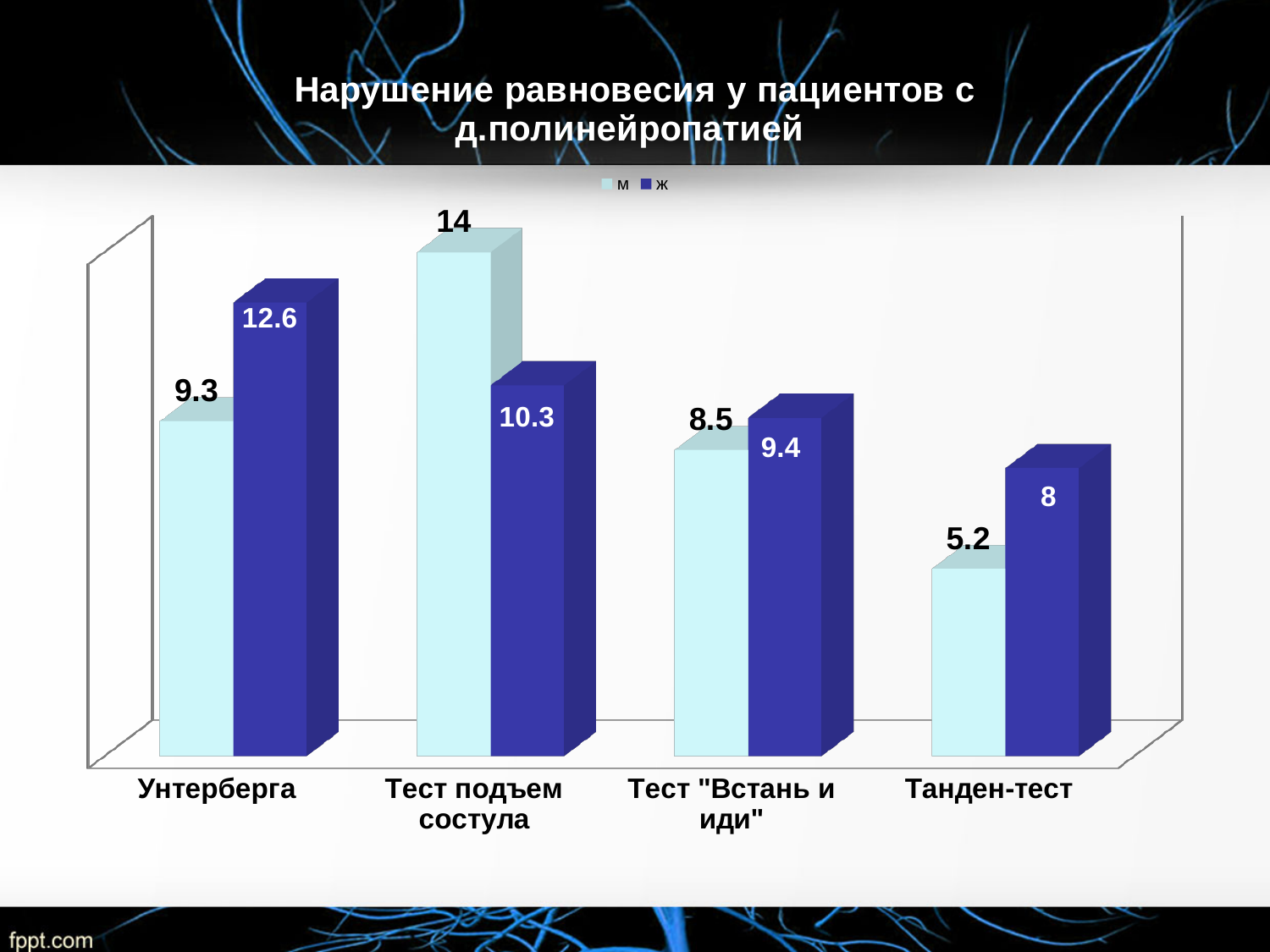
What is the value for "м" in the Унтерберга category? 9.3 In the Тест "Встань и иди" category, which series has the larger value, "м" or "ж"? ж What is the difference between the "м" and "ж" values in the Тест подъем состула category? 3.7 Which category has the highest value for the "м" series? Тест подъем состула What is the value for "ж" in the Тест подъем состула category? 10.3 What is the value for "ж" in the Танден-тест category? 8 Which category has the lowest value for the "ж" series? Танден-тест How many categories are shown on the x axis? 4 What kind of chart is shown on the slide? bar chart How many series does the legend list? 2 What is the difference between the "ж" and "м" values in the Унтерберга category? 3.3 What is the title of the chart? Нарушение равновесия у пациентов с д.полинейропатией